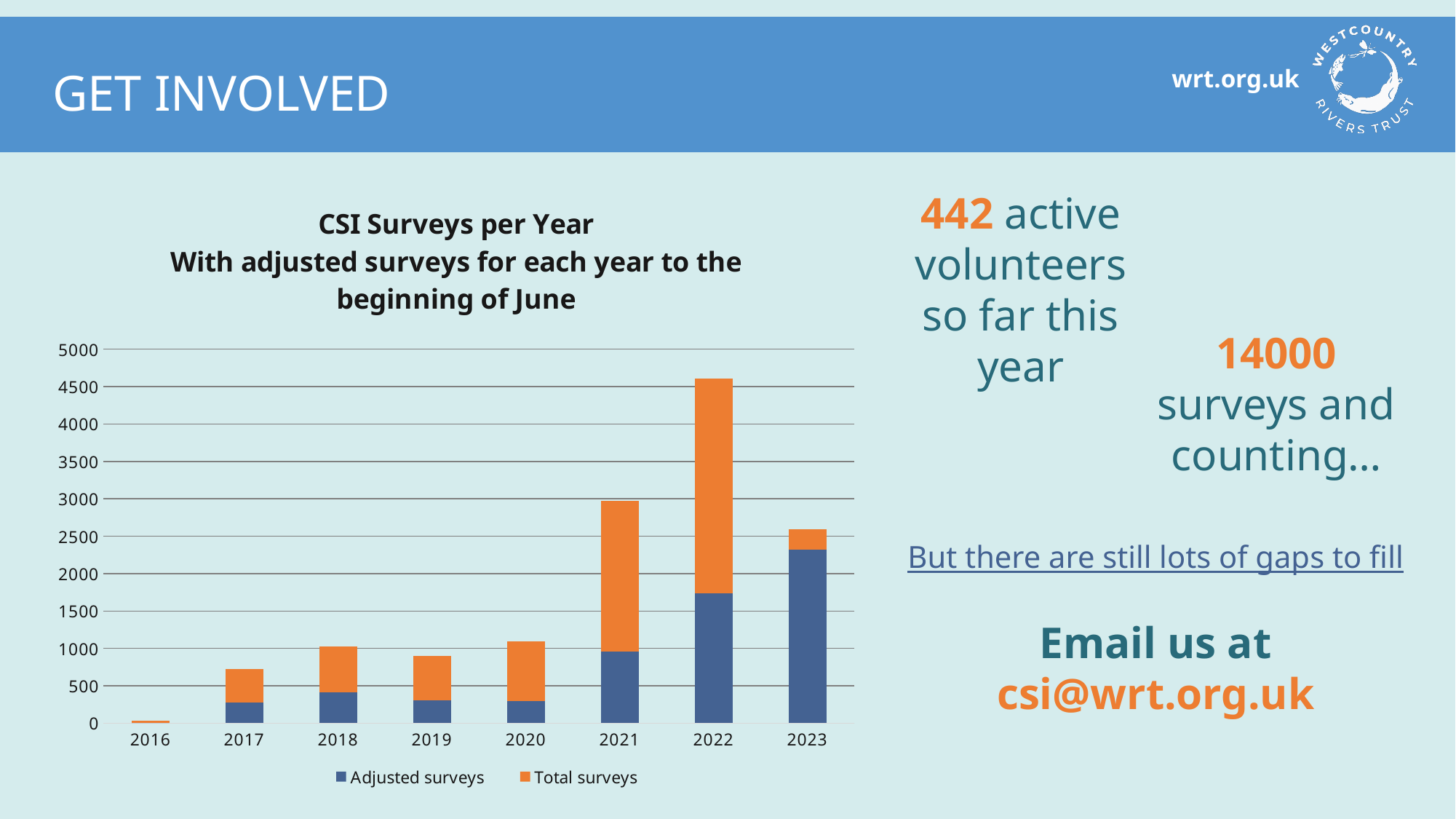
Is the top of the stacked bar for 2017 greater or less than 1000? less Is the Adjusted surveys value for 2023 greater or less than 2000? greater How many years are shown on the x axis of the chart? 8 Is the top of the stacked bar for 2022 greater or less than 4000? greater Which year has the larger Adjusted surveys value, 2022 or 2023? 2023 Which year has the tallest stacked bar in the chart? 2022 Do the stacked bar totals rise or fall from 2020 to 2022? Rise How many series does the chart's legend list? 2 Which year has the smallest stacked bar in the chart? 2016 What kind of chart is shown on the slide? Bar chart Which series is shown in orange in the chart's legend? Total surveys